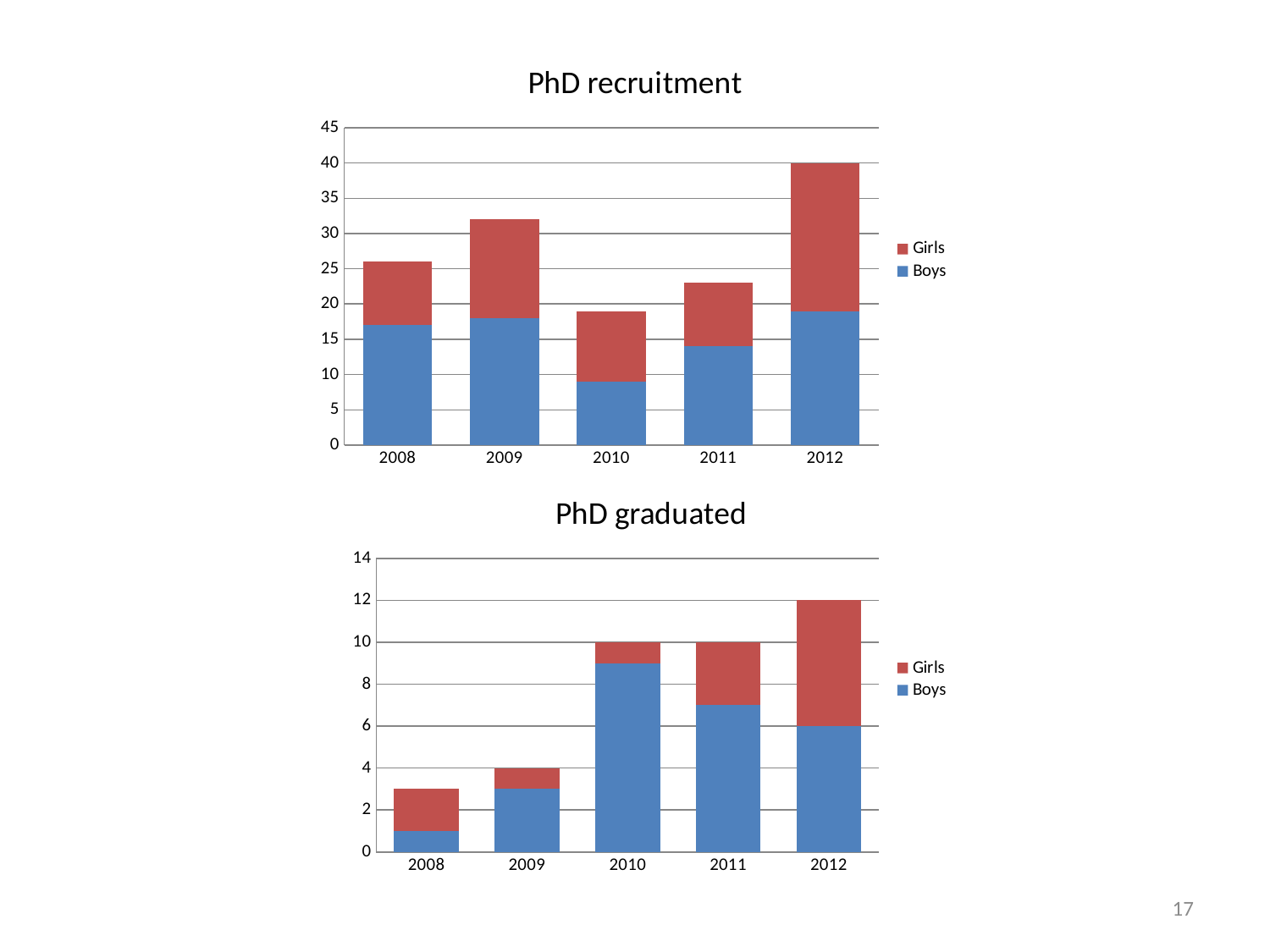
How many years are shown on the x axis of the 'PhD recruitment' chart? 5 What type of chart is the 'PhD recruitment' chart? stacked bar chart In the 'PhD recruitment' chart, is the Boys value for 2010 greater or less than 10? less In the 'PhD recruitment' chart, which year has the highest total bar? 2012 In the 'PhD recruitment' chart, which year has the lowest total bar? 2010 In the 'PhD recruitment' chart, is the total for 2009 greater or less than 30? greater In the 'PhD graduated' chart, which year has the lowest total bar? 2008 In the 'PhD graduated' chart, which series is shown in red? Girls How many series does the legend of the 'PhD graduated' chart list? 2 In the 'PhD graduated' chart, what is the Boys value for 2012? 6 In the 'PhD graduated' chart, which year has the highest total bar? 2012 In the 'PhD recruitment' chart, what is the total height of the 2012 bar? 40